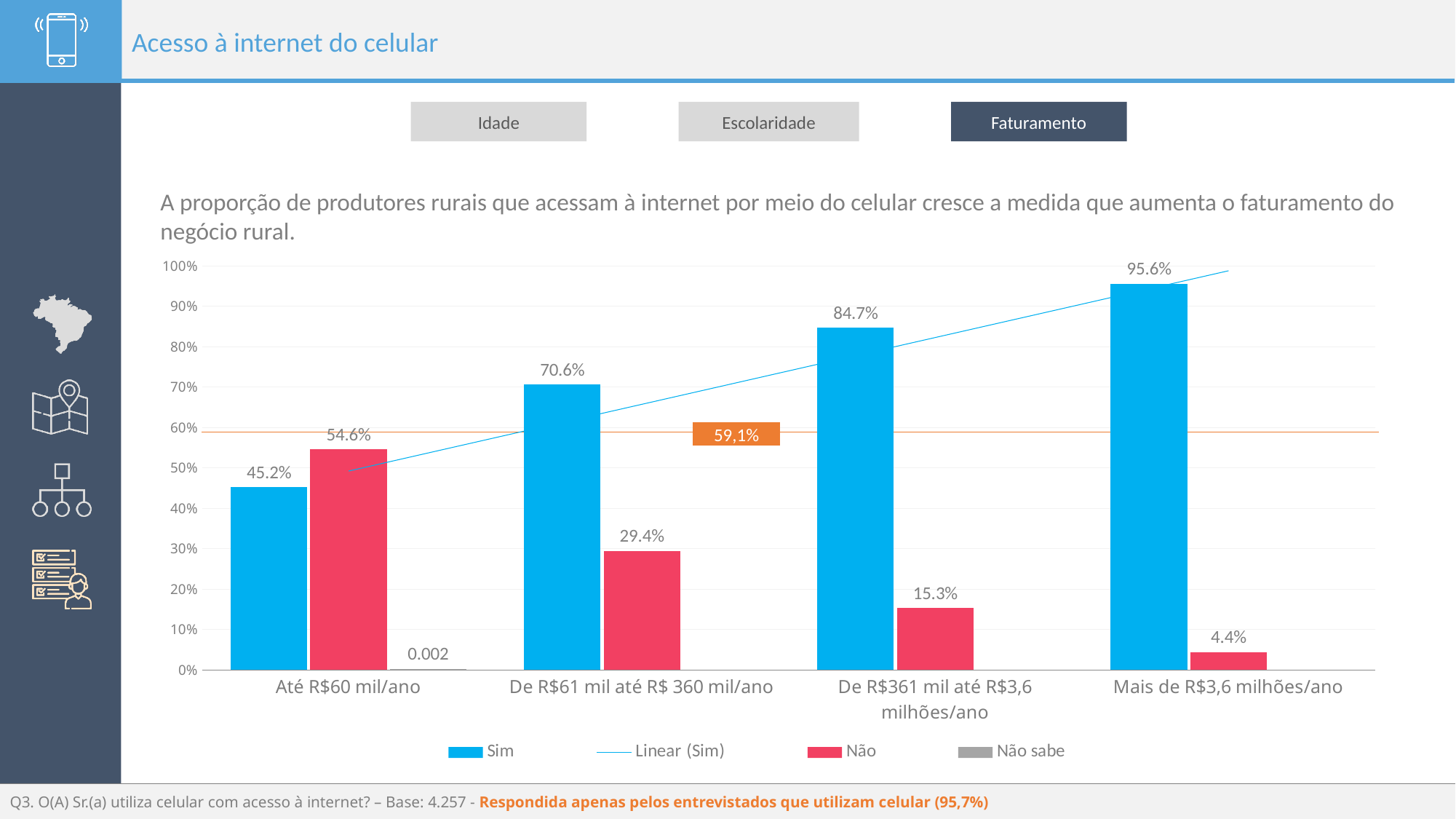
How many faturamento categories are shown on the x axis? 4 What is the 'Sim' value for 'Até R$60 mil/ano'? 45.2% For 'Até R$60 mil/ano', which is larger, the 'Sim' value or the 'Não' value? Não Which category has the lowest 'Não' value? Mais de R$3,6 milhões/ano Which category has the highest 'Sim' value? Mais de R$3,6 milhões/ano What is the 'Sim' value for 'Mais de R$3,6 milhões/ano'? 95.6% Do the 'Sim' values rise or fall as faturamento increases along the x axis? Rise How many entries does the legend list? 4 What kind of chart is shown on the slide? Bar chart What is the difference between the 'Sim' values for 'Mais de R$3,6 milhões/ano' and 'Até R$60 mil/ano'? 50.4% What is the 'Não' value for 'De R$61 mil até R$ 360 mil/ano'? 29.4% What is the 'Não' value for 'De R$361 mil até R$3,6 milhões/ano'? 15.3%